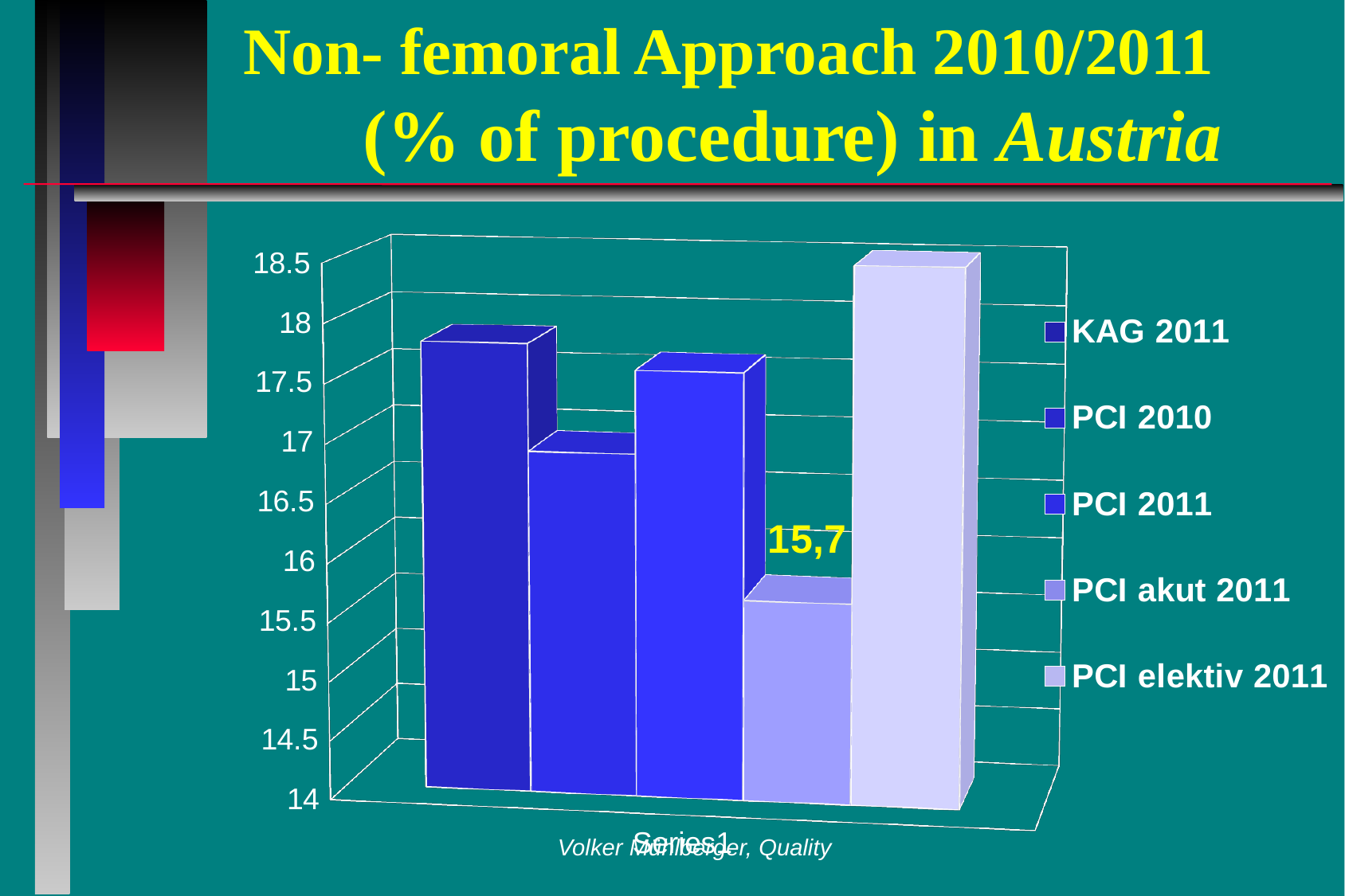
Is the value for PCI 2010 greater or less than 17.5? less What is the value shown for PCI akut 2011? 15,7 What is the title of the chart on the slide? Non- femoral Approach 2010/2011 (% of procedure) in Austria Is the value for PCI akut 2011 greater or less than 16? less Is the value for PCI elektiv 2011 greater or less than 18? greater Which series has the lowest bar? PCI akut 2011 How many series does the legend list? 5 Which is larger, the bar for PCI 2011 or the bar for PCI akut 2011? PCI 2011 Which series has the highest bar? PCI elektiv 2011 What type of chart is shown on the slide? bar chart Which is larger, the bar for KAG 2011 or the bar for PCI 2010? KAG 2011